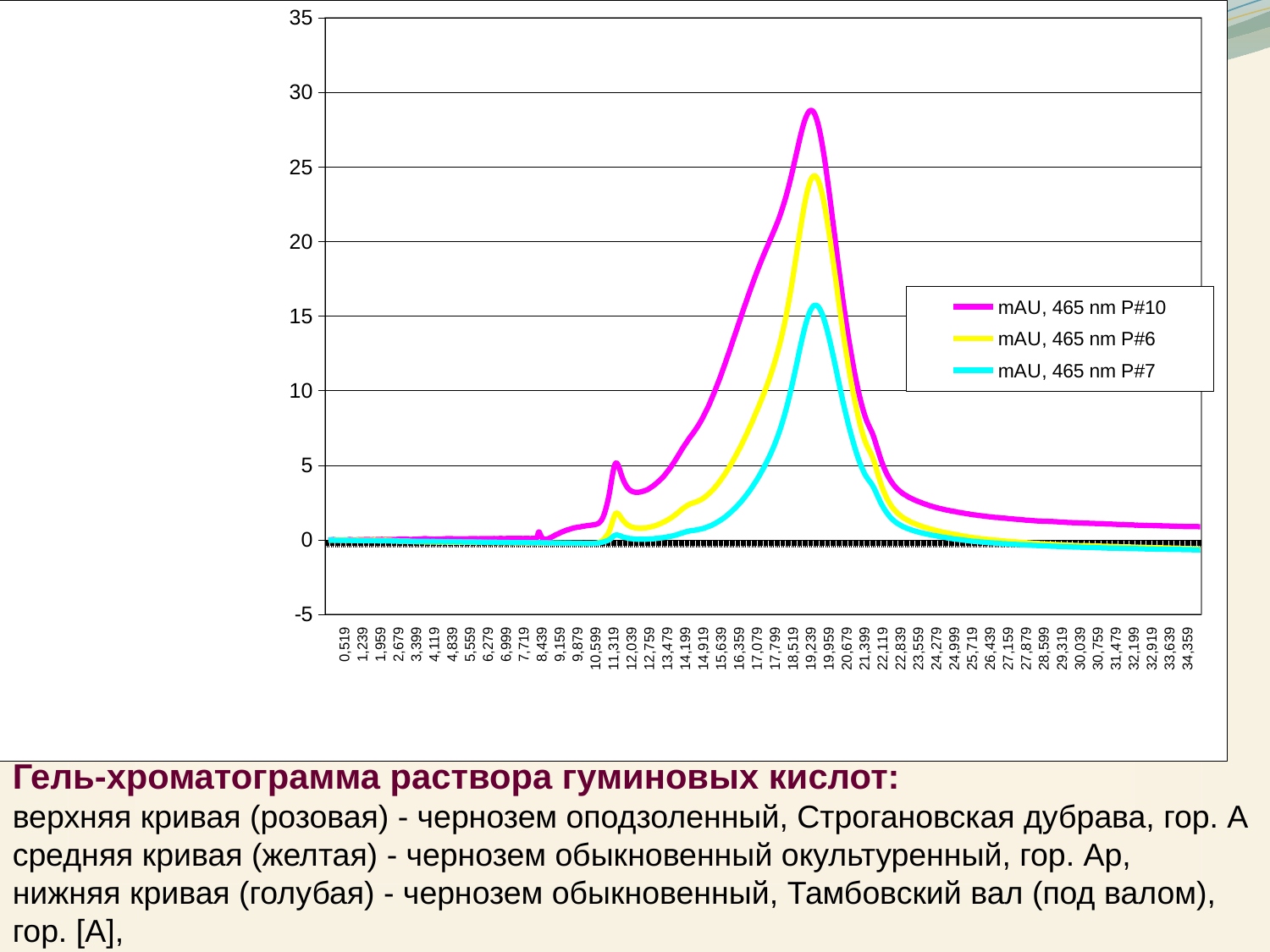
How many series does the legend list? 3 Which series reaches the highest peak value? mAU, 465 nm P#10 Is the peak value of the series mAU, 465 nm P#7 greater or less than 20? less Is the peak value of the series mAU, 465 nm P#6 greater or less than 20? greater What kind of chart is shown on the slide? line chart Is the peak value of the series mAU, 465 nm P#10 greater or less than 25? greater What is the maximum value shown on the vertical axis? 35 Which series has a higher peak, mAU, 465 nm P#6 or mAU, 465 nm P#7? mAU, 465 nm P#6 Which series has the lowest peak value? mAU, 465 nm P#7 What colour is the line for the series mAU, 465 nm P#6? yellow